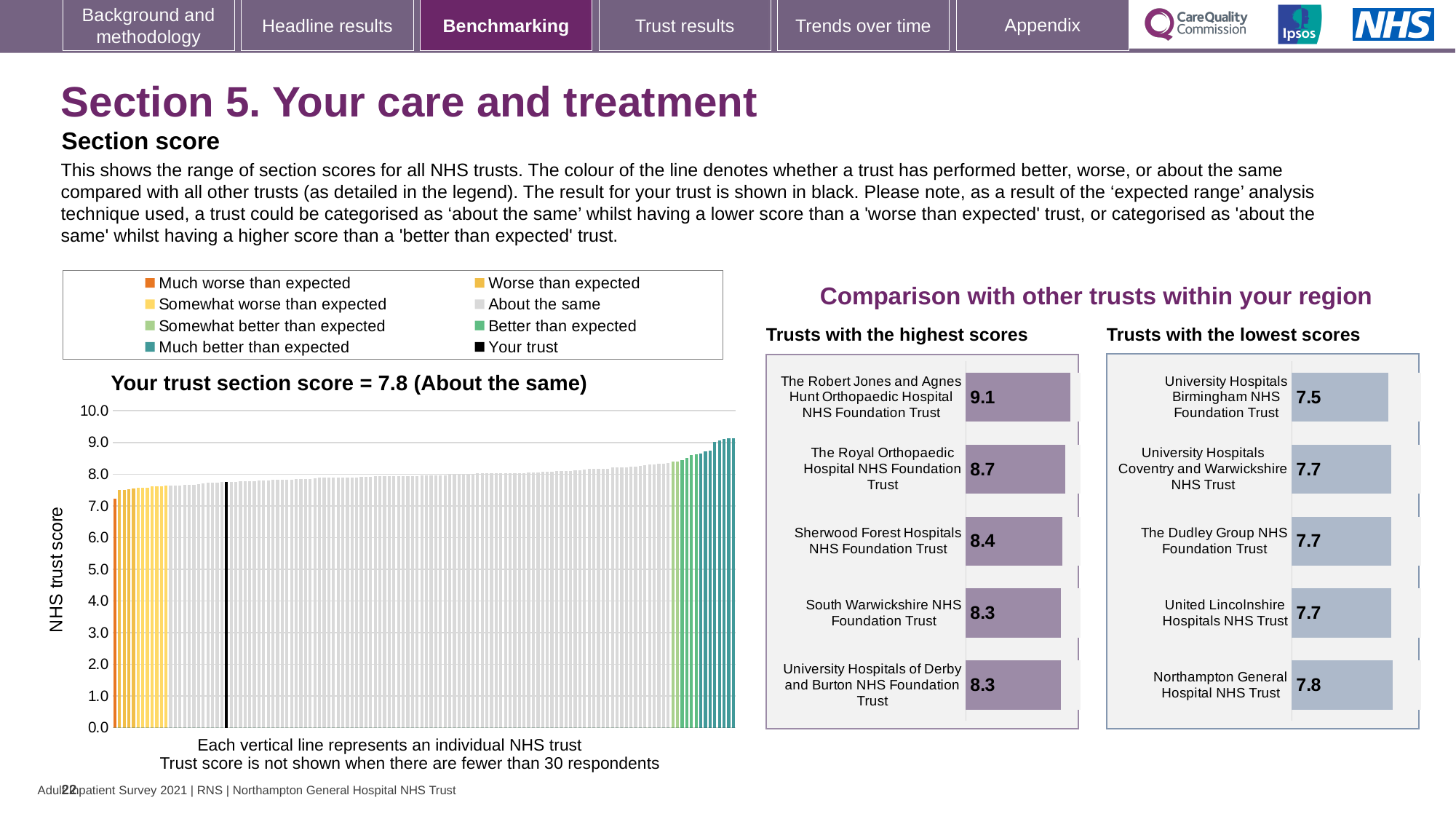
How many trusts are listed in the 'Trusts with the highest scores' chart? 5 According to the title of the main chart on the left, what is your trust's section score? 7.8 (About the same) What kind of chart is the main chart on the left titled 'Your trust section score = 7.8 (About the same)'? bar chart In the 'Trusts with the highest scores' chart, which has the larger score: Sherwood Forest Hospitals NHS Foundation Trust or South Warwickshire NHS Foundation Trust? Sherwood Forest Hospitals NHS Foundation Trust In the 'Trusts with the highest scores' chart, what is the score for The Robert Jones and Agnes Hunt Orthopaedic Hospital NHS Foundation Trust? 9.1 In the 'Trusts with the highest scores' chart, which trust has the highest score? The Robert Jones and Agnes Hunt Orthopaedic Hospital NHS Foundation Trust In the 'Trusts with the lowest scores' chart, what is the difference between the scores of Northampton General Hospital NHS Trust and University Hospitals Birmingham NHS Foundation Trust? 0.3 How many entries does the legend of the main chart on the left list? 8 In the 'Trusts with the highest scores' chart, what is the difference between the scores of The Robert Jones and Agnes Hunt Orthopaedic Hospital NHS Foundation Trust and The Royal Orthopaedic Hospital NHS Foundation Trust? 0.4 In the 'Trusts with the highest scores' chart, what is the score for Sherwood Forest Hospitals NHS Foundation Trust? 8.4 In the 'Trusts with the lowest scores' chart, which trust has the lowest score? University Hospitals Birmingham NHS Foundation Trust In the 'Trusts with the lowest scores' chart, what is the score for Northampton General Hospital NHS Trust? 7.8